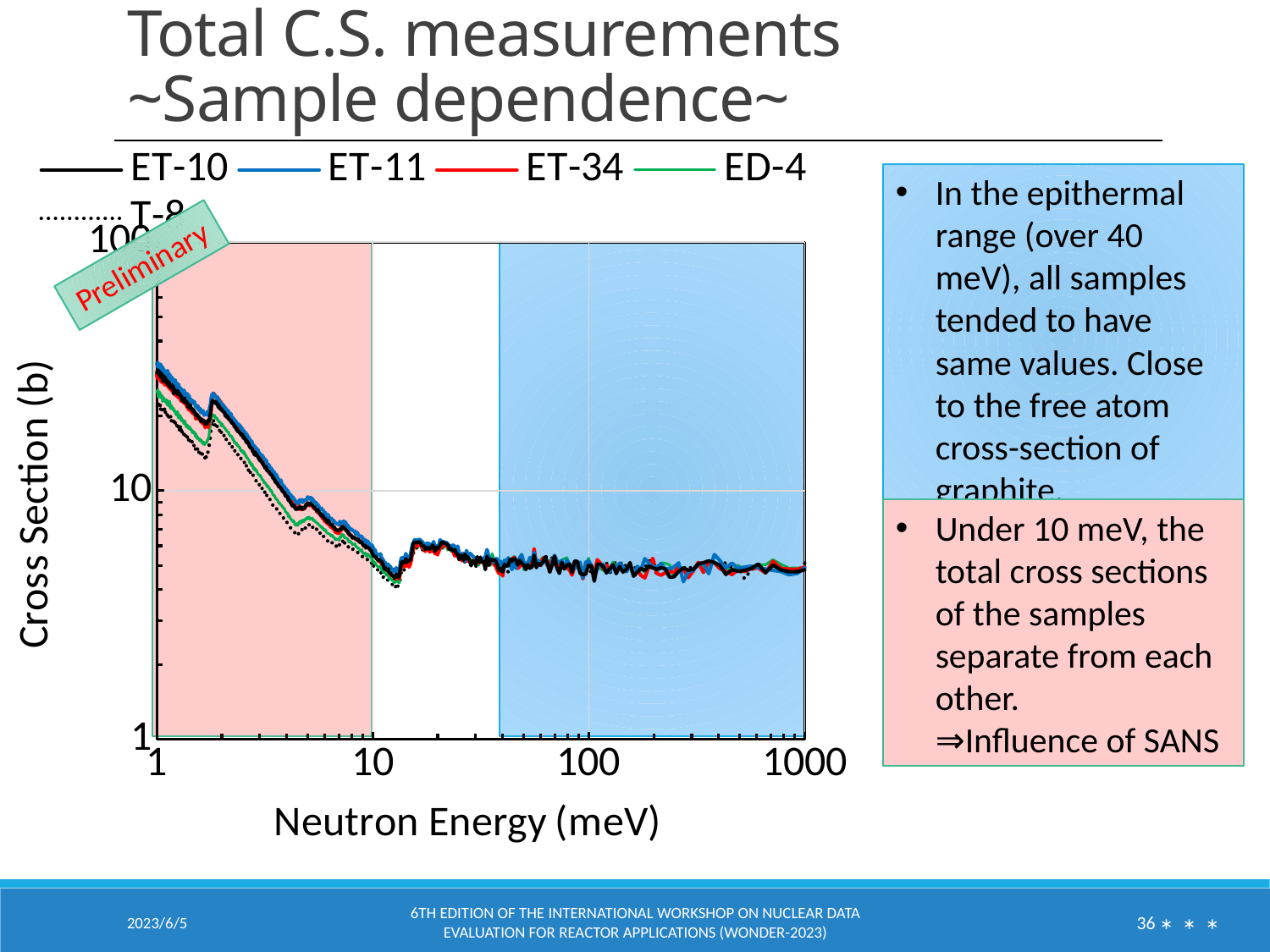
Is the cross section for ET-11 at 1 meV greater or less than 10 b? greater Is the cross section for ED-4 at 10 meV greater or less than 10 b? less How many series does the chart legend list? 5 At 1 meV, which has the higher cross section, ET-11 or ED-4? ET-11 What is the label of the x axis of the chart? Neutron Energy (meV) What kind of chart is shown on the slide? line chart Is the cross section for ET-10 at 100 meV greater or less than 10 b? less Between 1 meV and 10 meV, do the cross section values rise or fall as neutron energy increases? fall At 2 meV, which has the lower cross section, ET-11 or ED-4? ED-4 What colour is the line for ET-34 in the chart? red